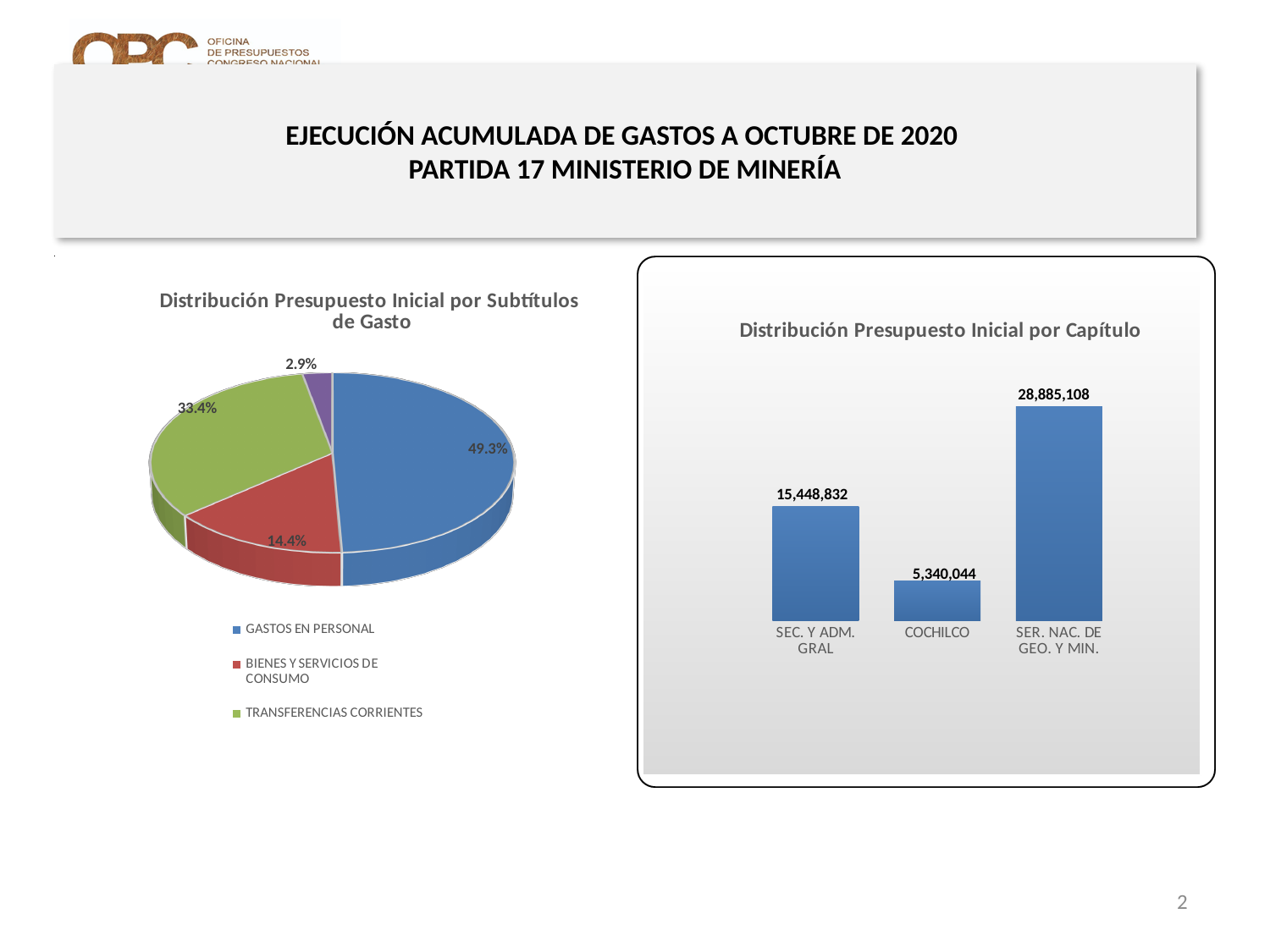
In the 'Distribución Presupuesto Inicial por Capítulo' chart, which category has the lowest value? COCHILCO What kind of chart is 'Distribución Presupuesto Inicial por Capítulo'? Bar chart In the 'Distribución Presupuesto Inicial por Subtítulos de Gasto' chart, what share does BIENES Y SERVICIOS DE CONSUMO have? 14.4% In the 'Distribución Presupuesto Inicial por Capítulo' chart, which category has the highest value? SER. NAC. DE GEO. Y MIN. In the 'Distribución Presupuesto Inicial por Subtítulos de Gasto' chart, which is larger: BIENES Y SERVICIOS DE CONSUMO or TRANSFERENCIAS CORRIENTES? TRANSFERENCIAS CORRIENTES In the 'Distribución Presupuesto Inicial por Capítulo' chart, how many categories are shown? 3 In the 'Distribución Presupuesto Inicial por Capítulo' chart, what is the difference between SER. NAC. DE GEO. Y MIN. and SEC. Y ADM. GRAL? 13,436,276 In the 'Distribución Presupuesto Inicial por Capítulo' chart, what is the value for SEC. Y ADM. GRAL? 15,448,832 In the 'Distribución Presupuesto Inicial por Capítulo' chart, what is the value for COCHILCO? 5,340,044 In the 'Distribución Presupuesto Inicial por Subtítulos de Gasto' chart, what share does GASTOS EN PERSONAL have? 49.3% In the 'Distribución Presupuesto Inicial por Subtítulos de Gasto' chart, what share does TRANSFERENCIAS CORRIENTES have? 33.4% What kind of chart is 'Distribución Presupuesto Inicial por Subtítulos de Gasto'? Pie chart